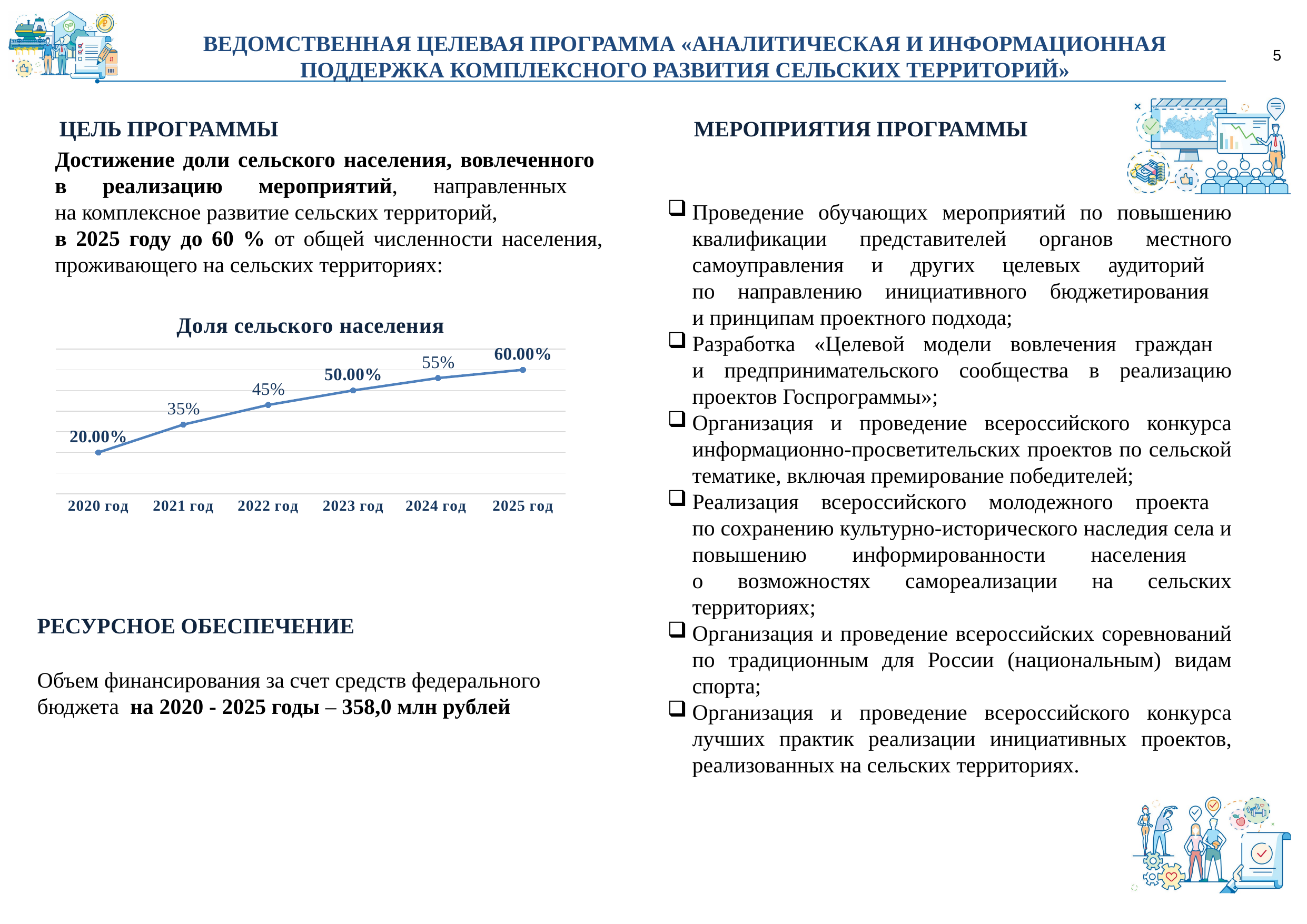
What kind of chart is shown on the slide? Line chart What is the difference between the values for 2022 год and 2021 год? 10% What is the value for 2025 год in the chart? 60.00% What is the value for 2024 год in the chart? 55% How many years are plotted on the x axis of the chart? 6 What is the value for 2023 год in the chart? 50.00% What is the value for 2022 год in the chart? 45% Which is larger, the value for 2023 год or the value for 2024 год? 2024 год Which year has the highest value in the chart? 2025 год What is the value for 2020 год in the chart? 20.00% What is the value for 2021 год in the chart? 35% Which year has the lowest value in the chart? 2020 год